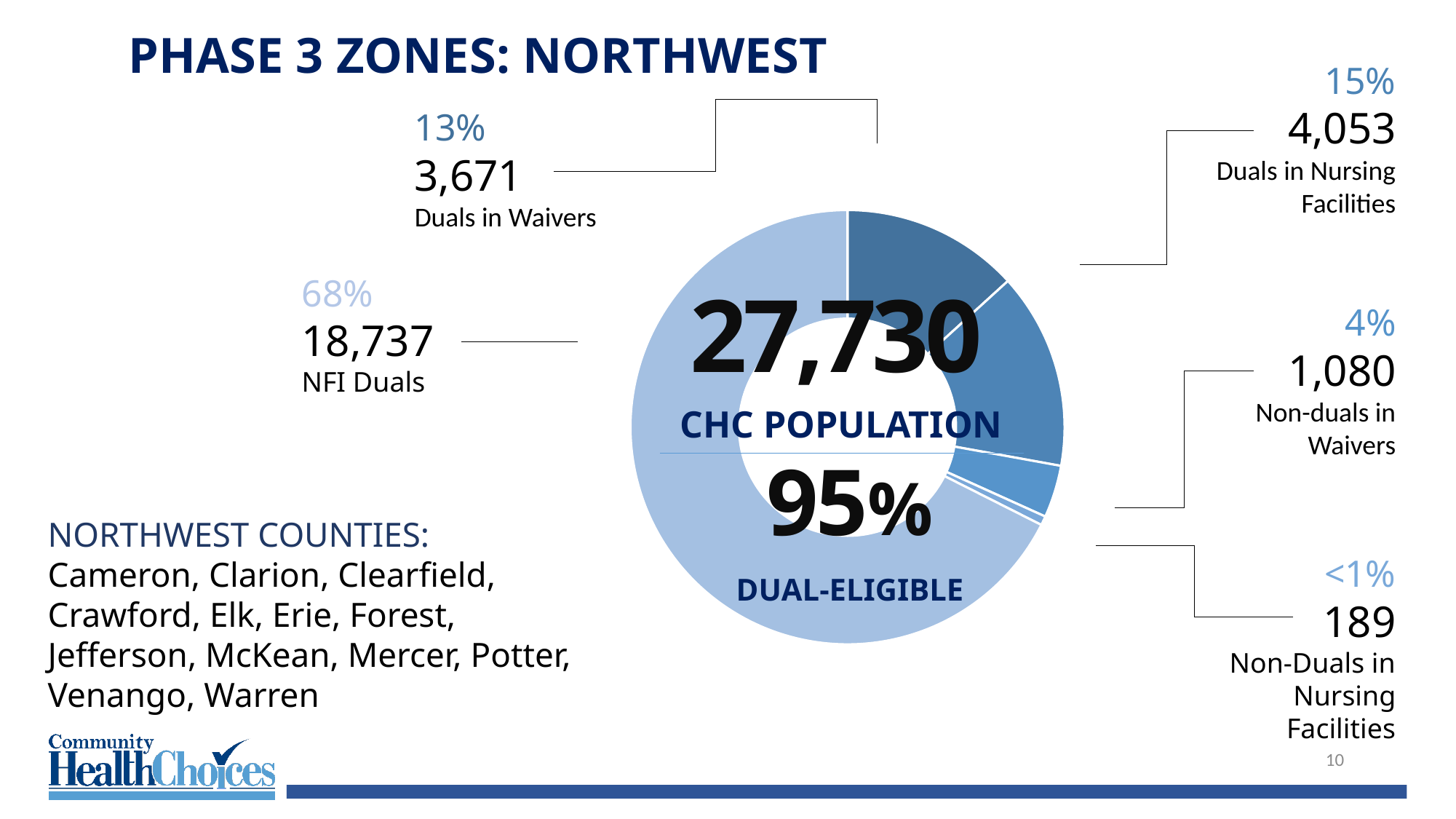
What share of the chart do Non-Duals in Nursing Facilities represent? <1% What is the value for Non-duals in Waivers? 1,080 What kind of chart is shown on the slide? Pie chart (donut) What is the value for NFI Duals? 18,737 What share of the chart do Duals in Waivers represent? 13% Which category has the smallest segment? Non-Duals in Nursing Facilities What is the difference between Duals in Nursing Facilities and Duals in Waivers? 382 How many segments does the donut chart have? 5 Which category has the largest segment? NFI Duals What is the value for Duals in Nursing Facilities? 4,053 What total CHC population is shown in the centre of the chart? 27,730 Which is larger, Duals in Waivers or Non-duals in Waivers? Duals in Waivers